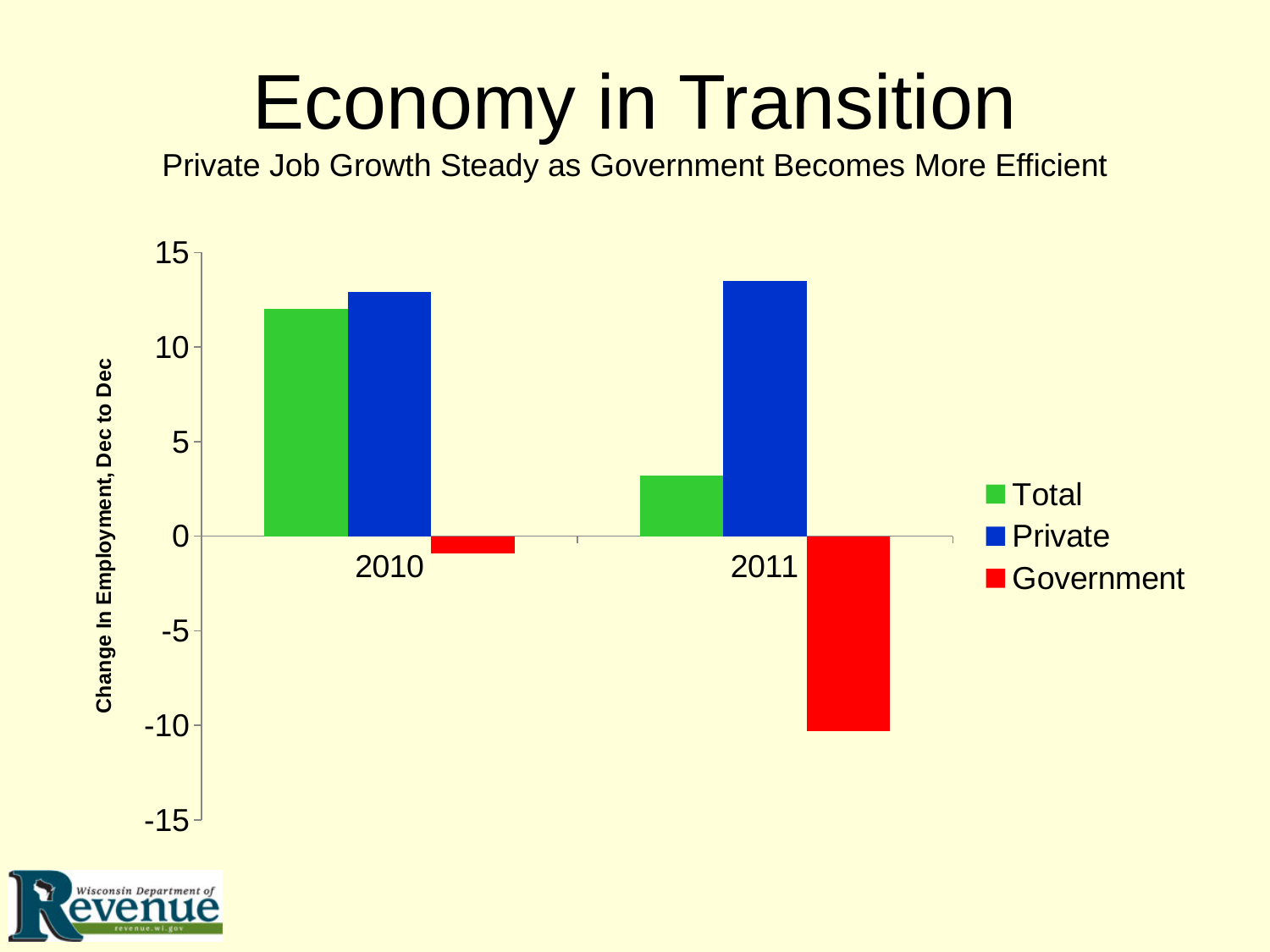
Is the value for Government in 2010 greater or less than 0? less Which series has the lowest value in 2011? Government What kind of chart is shown on the slide? bar chart Is the value for Total in 2011 greater or less than 5? less What colour represents the Government series? red How many years are shown on the x axis? 2 Which series has the highest value in 2011? Private Which is larger, the Total value for 2010 or the Total value for 2011? 2010 How many series does the legend list? 3 Is the value for Private in 2010 greater or less than 10? greater Does the Total value rise or fall from 2010 to 2011? fall